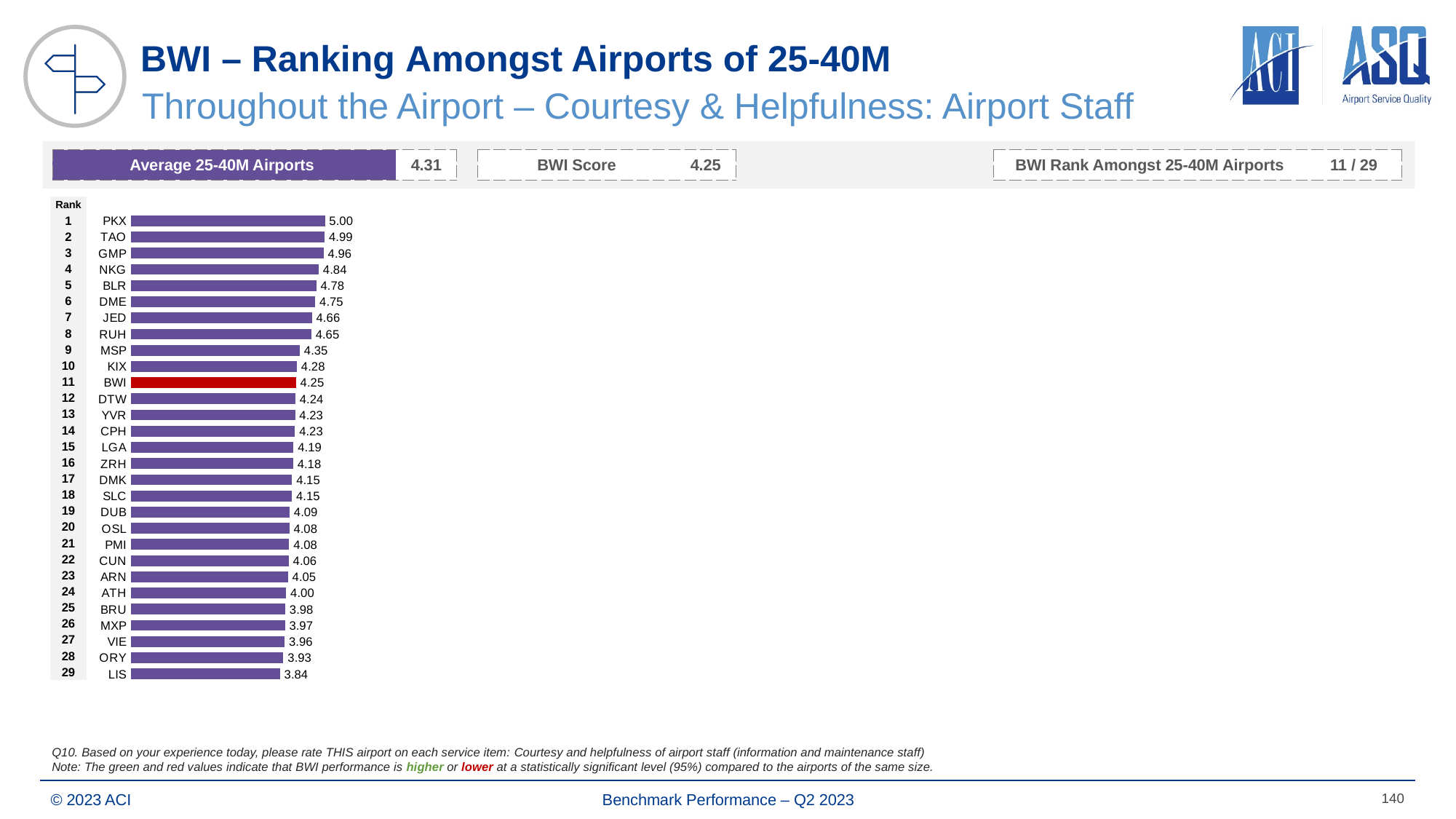
What is the difference between the score of BWI and the score of KIX? 0.03 What is the score for ATH in the ranking chart? 4.00 What kind of chart is shown on the slide? Bar chart What is the score for BWI in the ranking chart? 4.25 Which bar in the chart is coloured red? BWI Which airport has the highest score in the chart? PKX Which has a higher score, JED or DTW? JED What rank does BWI hold amongst 25-40M airports? 11 / 29 How many airports are ranked in the chart? 29 What is the difference between the scores of PKX and LIS? 1.16 Which airport has the lowest score in the chart? LIS What is the score for MSP in the ranking chart? 4.35